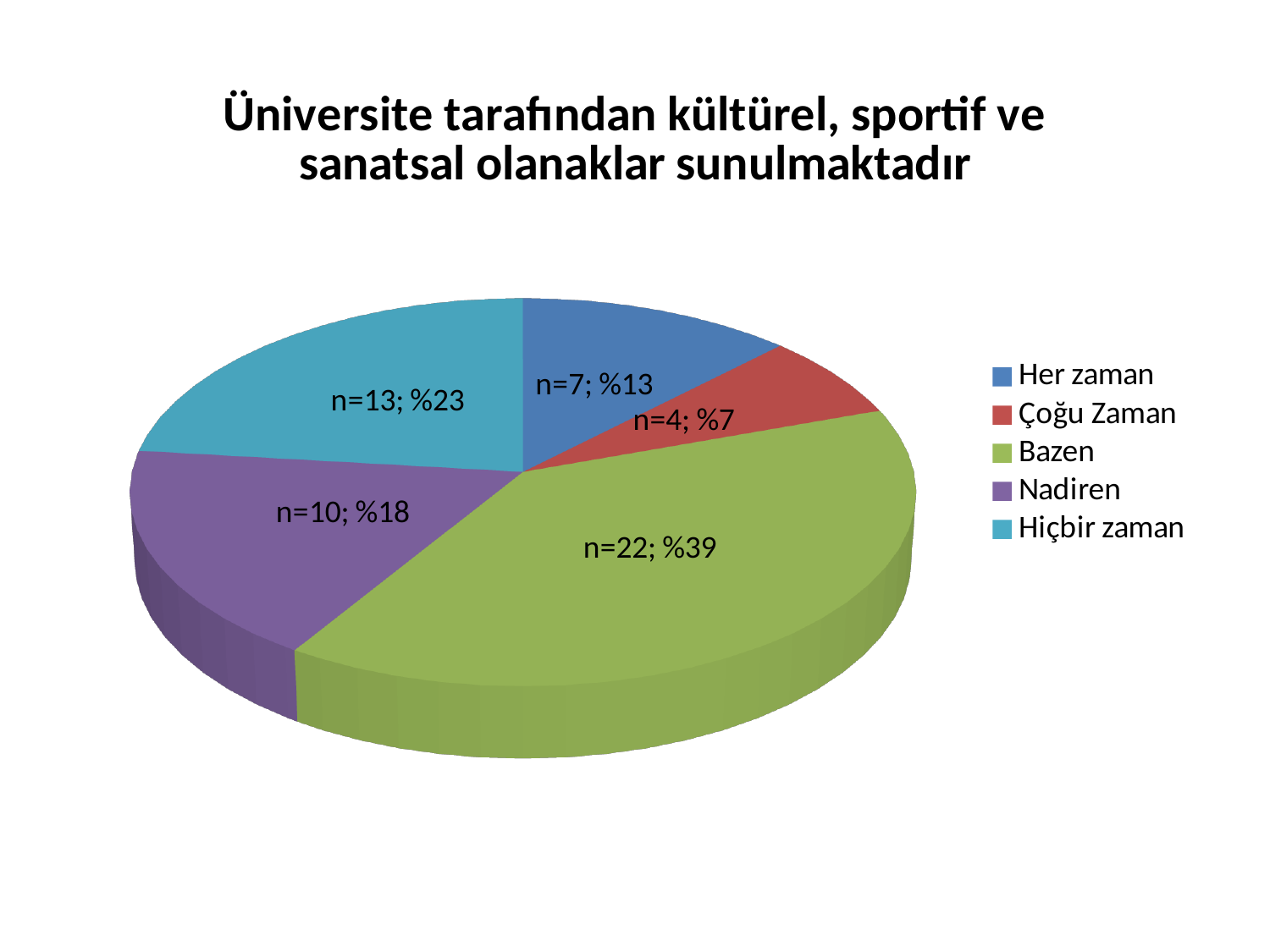
Which category has the smallest slice? Çoğu Zaman What kind of chart is shown on the slide? pie chart What is the difference in count (n) between Bazen and Nadiren? 12 What percentage is shown for the Nadiren slice? %18 What colour is the Bazen slice in the pie chart? green What is the count (n) for the Bazen slice? n=22 Which category has the largest slice? Bazen How many slices does the pie chart have? 5 What is the count (n) for the Çoğu Zaman slice? n=4 Which is larger, the Her zaman slice or the Hiçbir zaman slice? Hiçbir zaman What share of the pie does the Her zaman slice represent? %13 What percentage is shown for the Hiçbir zaman slice? %23